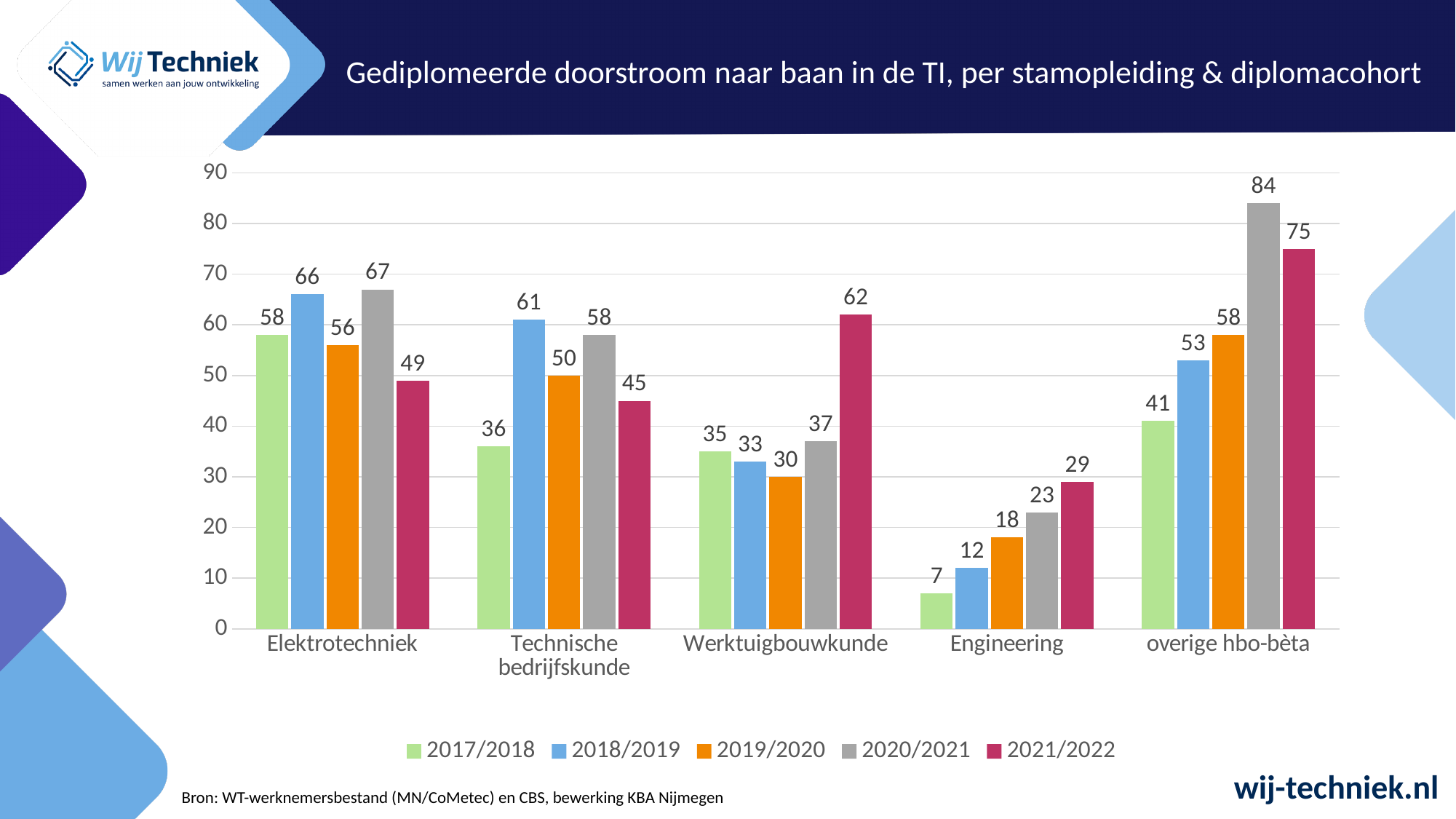
What kind of chart is shown on the slide? bar chart How many categories are shown on the x axis? 5 Do the values for Engineering rise or fall from 2017/2018 to 2021/2022? rise What is the value for Werktuigbouwkunde in the 2021/2022 series? 62 Which category has the highest value in the 2020/2021 series? overige hbo-bèta What is the value for Engineering in the 2017/2018 series? 7 What is the value for Elektrotechniek in the 2018/2019 series? 66 Which is larger for Technische bedrijfskunde: the 2018/2019 value or the 2020/2021 value? 2018/2019 Which category has the lowest value in the 2019/2020 series? Engineering What is the difference between the 2020/2021 and 2021/2022 values for overige hbo-bèta? 9 What is the title of the chart? Gediplomeerde doorstroom naar baan in de TI, per stamopleiding & diplomacohort How many series does the legend list? 5